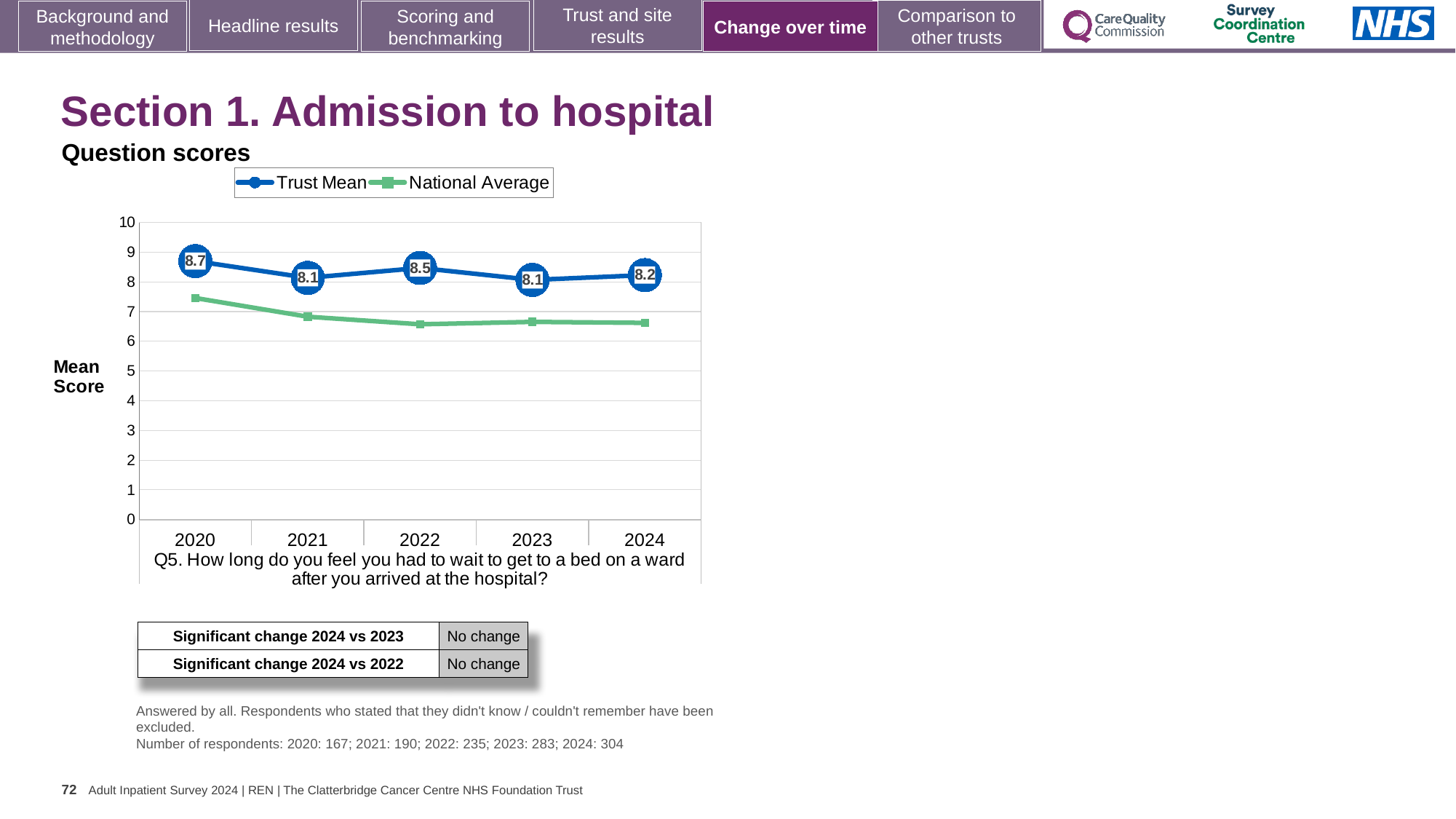
Is the National Average value for 2022 greater or less than 7? less What is the difference between the Trust Mean score in 2020 and in 2021? 0.6 Which series is plotted in green? National Average What is the Trust Mean score for 2024? 8.2 Which is larger, the Trust Mean score in 2022 or in 2023? 2022 Is the National Average value for 2020 greater or less than 7? greater How many years are plotted on the x axis? 5 What is the Trust Mean score for 2022? 8.5 What kind of chart is shown? Line chart How many series does the legend list? 2 What is the Trust Mean score for 2020? 8.7 In which year is the Trust Mean score highest? 2020